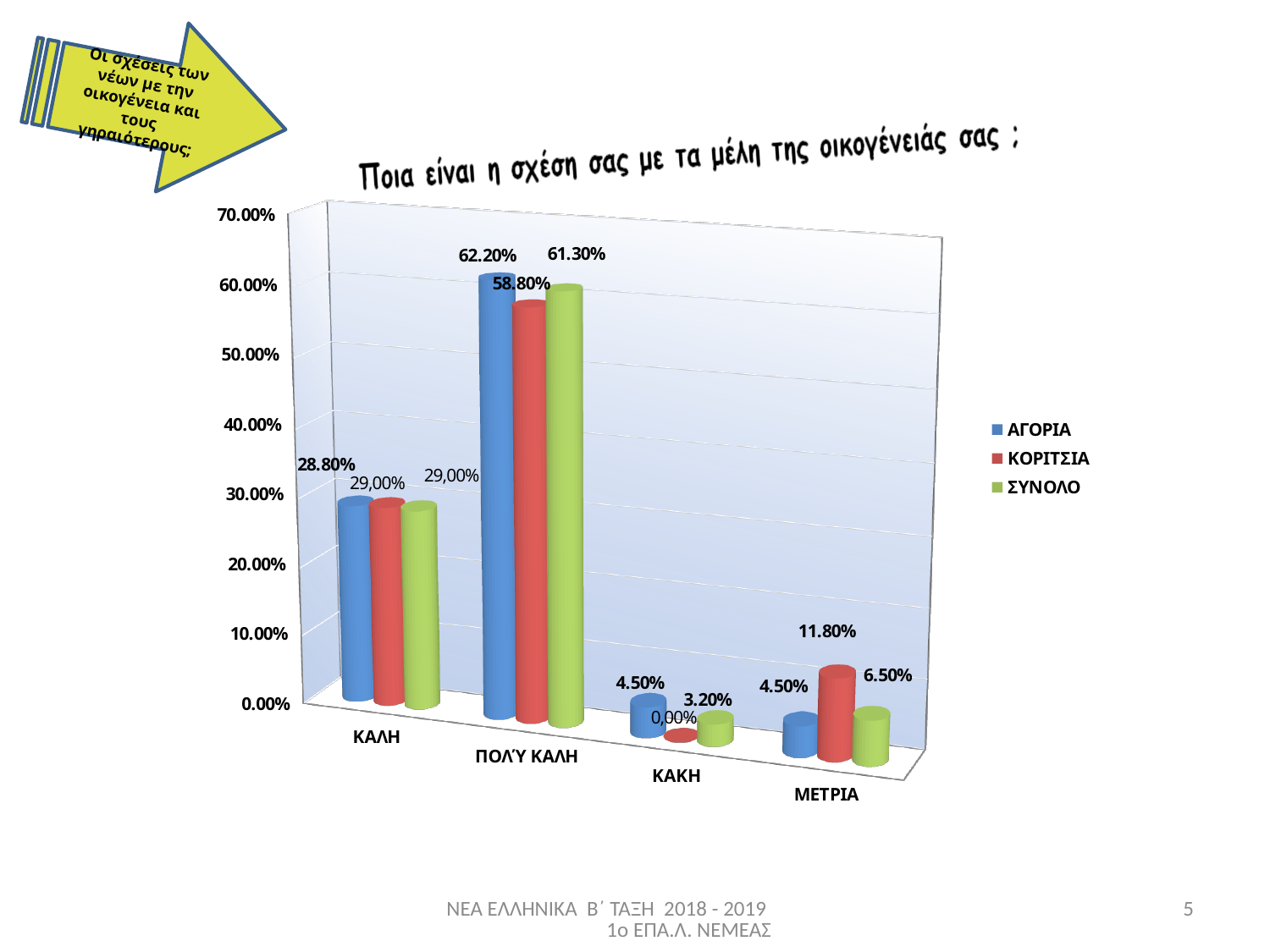
Which category has the highest value for ΣΥΝΟΛΟ? ΠΟΛΎ ΚΑΛΗ What is the difference between the ΑΓΟΡΙΑ and ΚΟΡΙΤΣΙΑ values in the ΠΟΛΎ ΚΑΛΗ category? 3.40% How many series does the legend list? 3 What is the value for ΚΟΡΙΤΣΙΑ in the ΜΕΤΡΙΑ category? 11.80% What is the value for ΑΓΟΡΙΑ in the ΠΟΛΎ ΚΑΛΗ category? 62.20% Which category has the lowest value for ΚΟΡΙΤΣΙΑ? ΚΑΚΗ What is the value for ΚΟΡΙΤΣΙΑ in the ΚΑΚΗ category? 0,00% Which colour represents the ΣΥΝΟΛΟ series? Green What kind of chart is shown on the slide? Bar chart In the ΜΕΤΡΙΑ category, which is larger: ΑΓΟΡΙΑ or ΚΟΡΙΤΣΙΑ? ΚΟΡΙΤΣΙΑ What is the value for ΣΥΝΟΛΟ in the ΚΑΚΗ category? 3.20% How many categories are shown on the x axis? 4